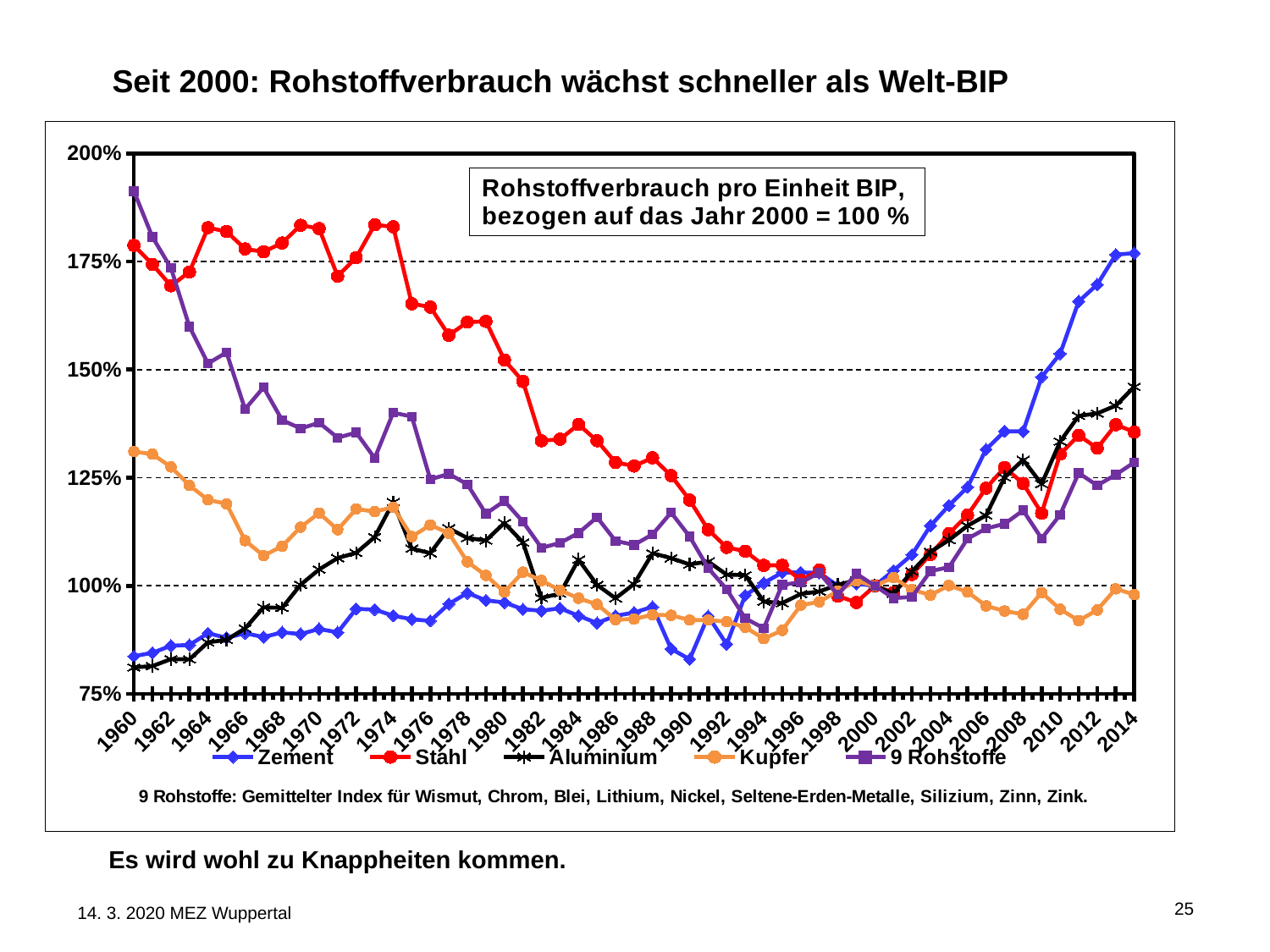
Is the value for Aluminium in 2014 greater or less than 125%? greater Is the value for Stahl in 1960 greater or less than 175%? greater Does the Stahl series rise or fall from 1960 to 2000? fall Is the value for Kupfer in 1994 greater or less than 100%? less In 2014, which is higher: Zement or Stahl? Zement Does the Zement series rise or fall from 2000 to 2014? rise Which series are listed in the legend? Zement, Stahl, Aluminium, Kupfer, 9 Rohstoffe How many series does the legend list? 5 Which series has the highest value in 1960? 9 Rohstoffe What does the text box inside the chart say? Rohstoffverbrauch pro Einheit BIP, bezogen auf das Jahr 2000 = 100 % What kind of chart is shown on the slide? line chart